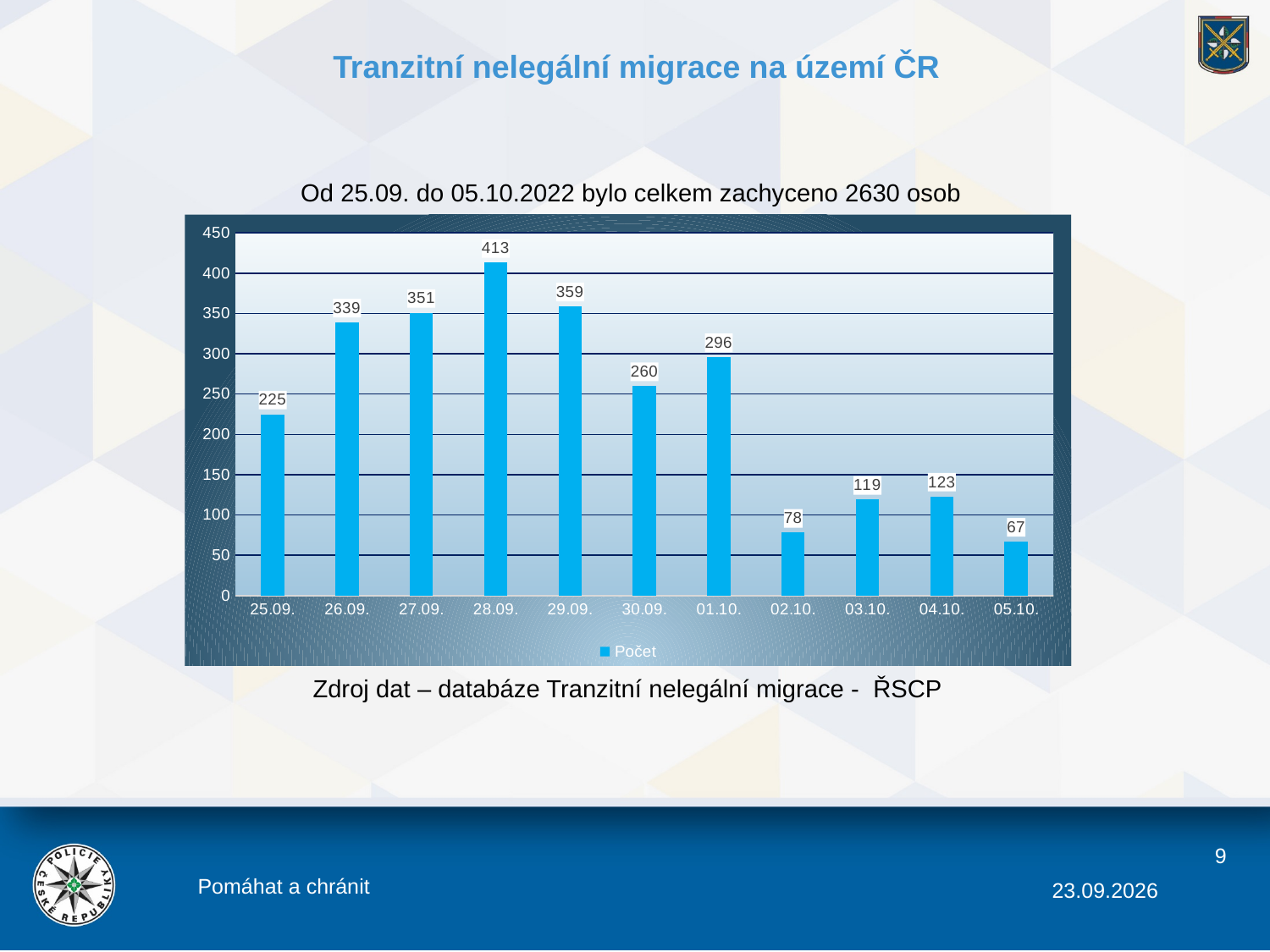
How many series does the legend list? 1 What is the difference between the values for 28.09. and 05.10.? 346 Which is larger, the value for 26.09. or the value for 29.09.? 29.09. Is the value for 01.10. greater or less than 250? greater What is the value for 02.10.? 78 What is the value for 28.09.? 413 Do the values rise or fall from 01.10. to 02.10.? fall Which date has the lowest value? 05.10. Which date has the highest value? 28.09. How many dates are shown on the x axis? 11 What kind of chart is shown? bar chart What is the name of the series in the legend? Počet